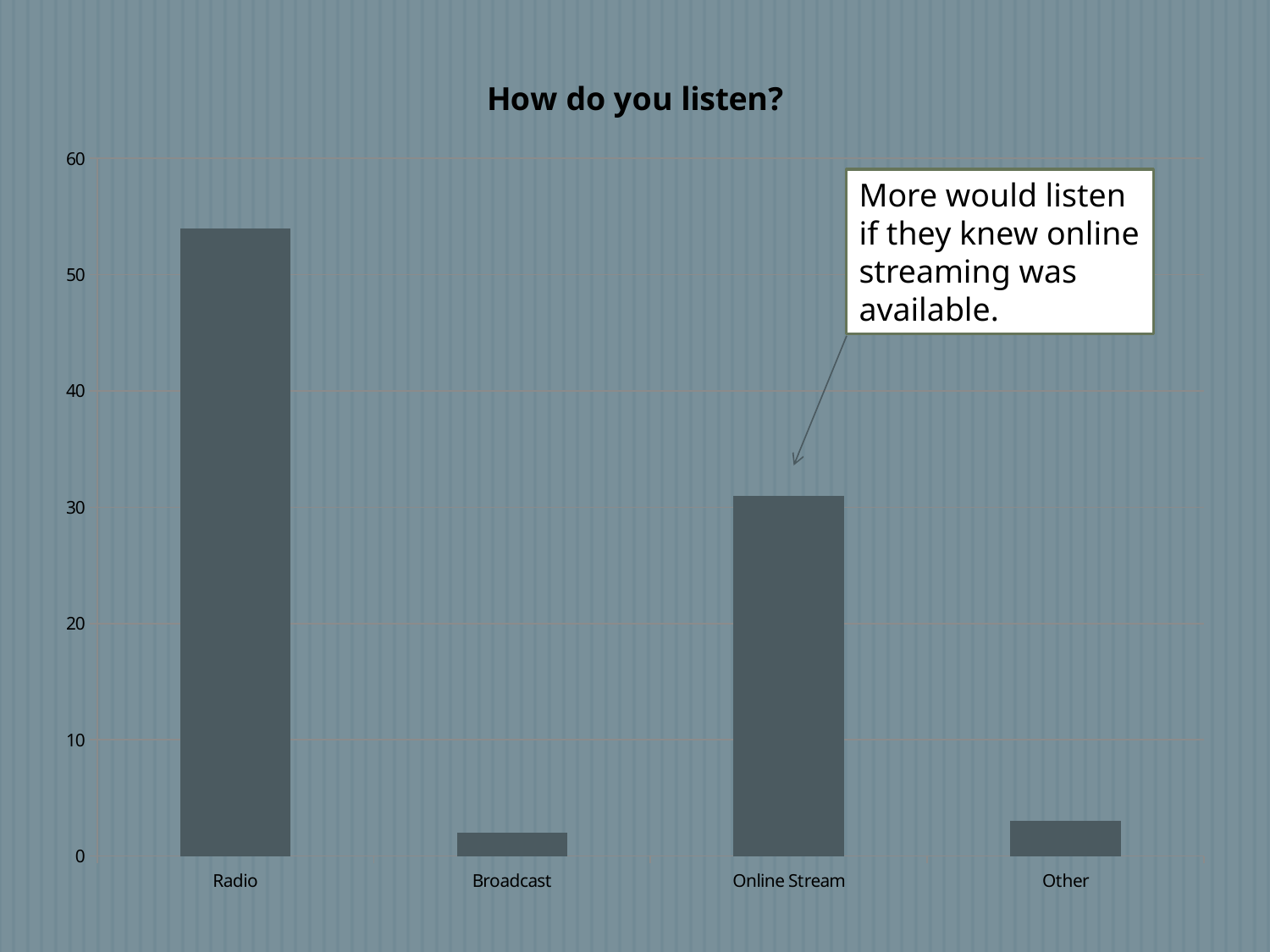
What is the title of the chart? How do you listen? Which is larger, the value for Online Stream or the value for Broadcast? Online Stream Which category has the highest value in the chart? Radio How many categories are shown on the x axis of the chart? 4 Is the value for Other greater or less than 10? less What kind of chart is shown on the slide? bar chart Is the value for Online Stream greater or less than 40? less Which is larger, the value for Radio or the value for Online Stream? Radio Is the value for Broadcast greater or less than 10? less What does the callout box on the chart say? More would listen if they knew online streaming was available.